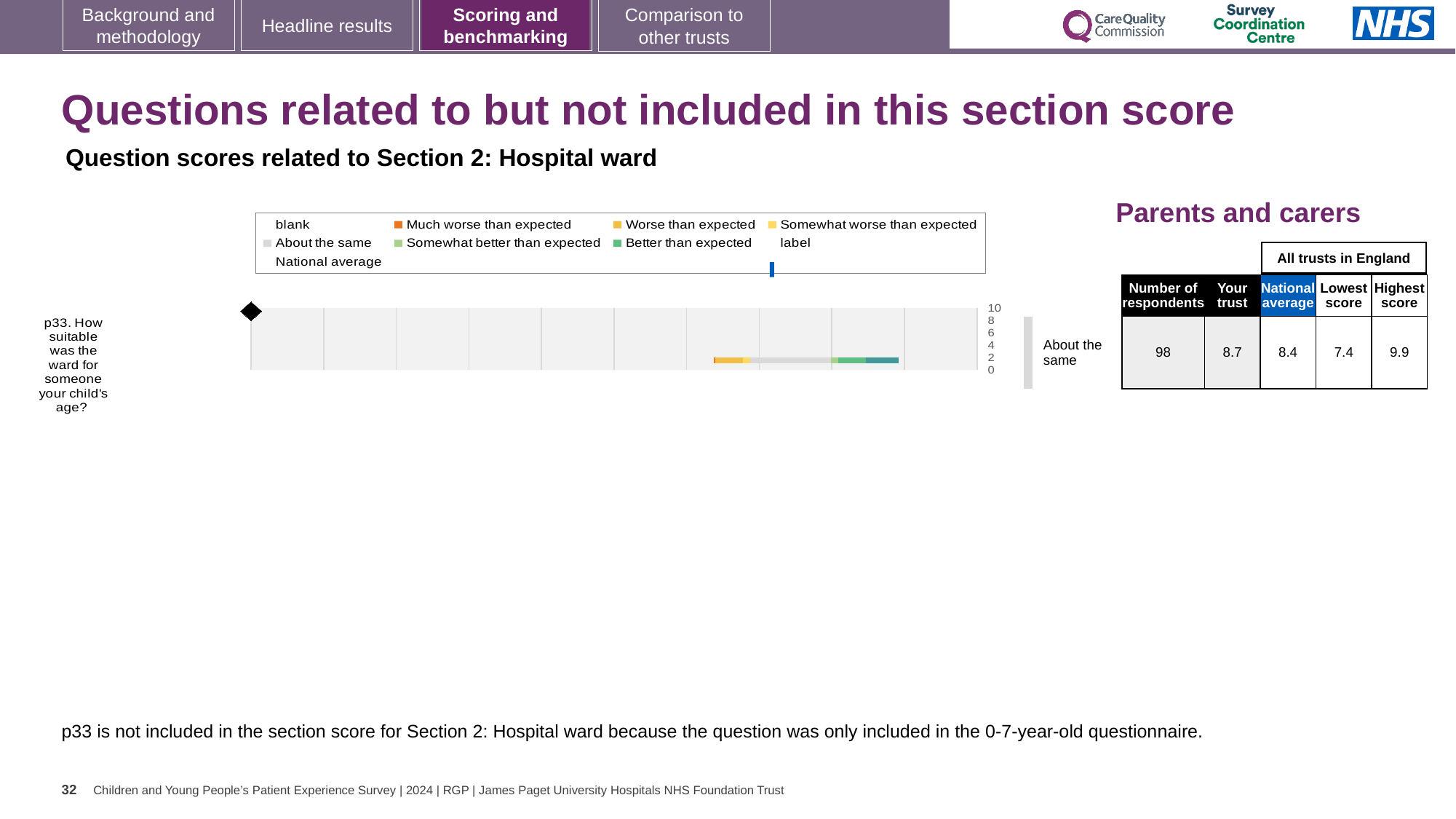
What kind of chart is shown on the slide? bar chart In the table, what is the highest score among all trusts in England for p33? 9.9 In the table, what is the national average score for p33? 8.4 In the table, what is the difference between the highest score and the lowest score for p33? 2.5 Which question is plotted on the chart? p33. How suitable was the ward for someone your child's age? What is the highest tick value shown on the chart's axis? 10 What rating label is shown to the right of the chart for p33? About the same In the table, what is the lowest score among all trusts in England for p33? 7.4 How many question categories are plotted on the chart? 1 In the table, is the 'Your trust' score for p33 larger or smaller than the national average? larger In the table, what is the 'Your trust' score for p33? 8.7 In the table, what is the number of respondents for p33? 98